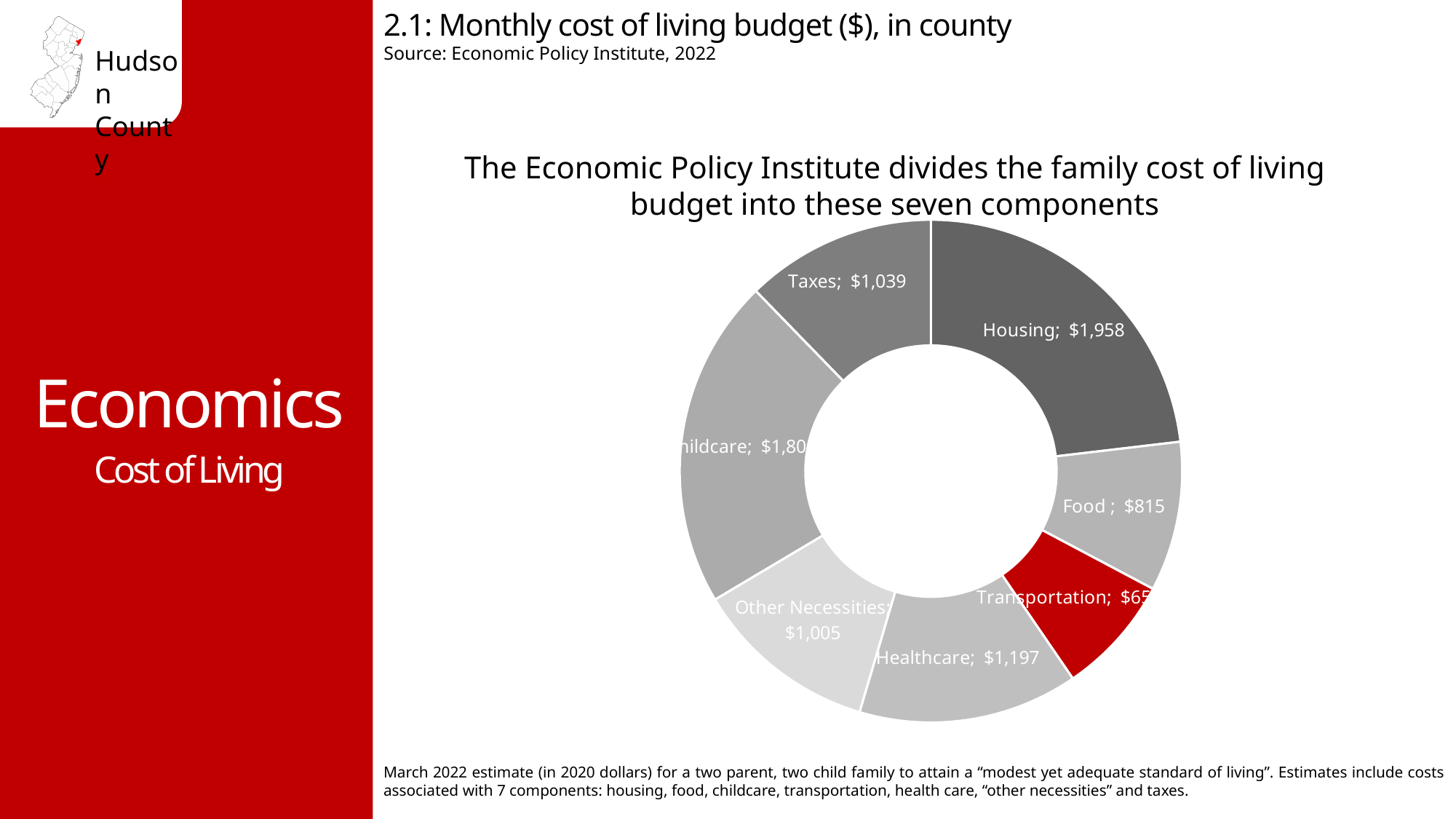
What is the monthly cost for Other Necessities in the chart? $1,005 Which is larger, the cost for Taxes or the cost for Other Necessities? Taxes What is the monthly cost for Housing in the chart? $1,958 What is the difference between the Healthcare cost and the Taxes cost? $158 How many components are shown in the chart? 7 What is the monthly cost for Taxes in the chart? $1,039 What is the difference between the Housing cost and the Food cost? $1,143 What kind of chart is shown on the slide? Pie (doughnut) chart Which component has the largest monthly cost in the chart? Housing What is the monthly cost for Healthcare in the chart? $1,197 Which component has the smallest monthly cost in the chart? Transportation What is the monthly cost for Food in the chart? $815